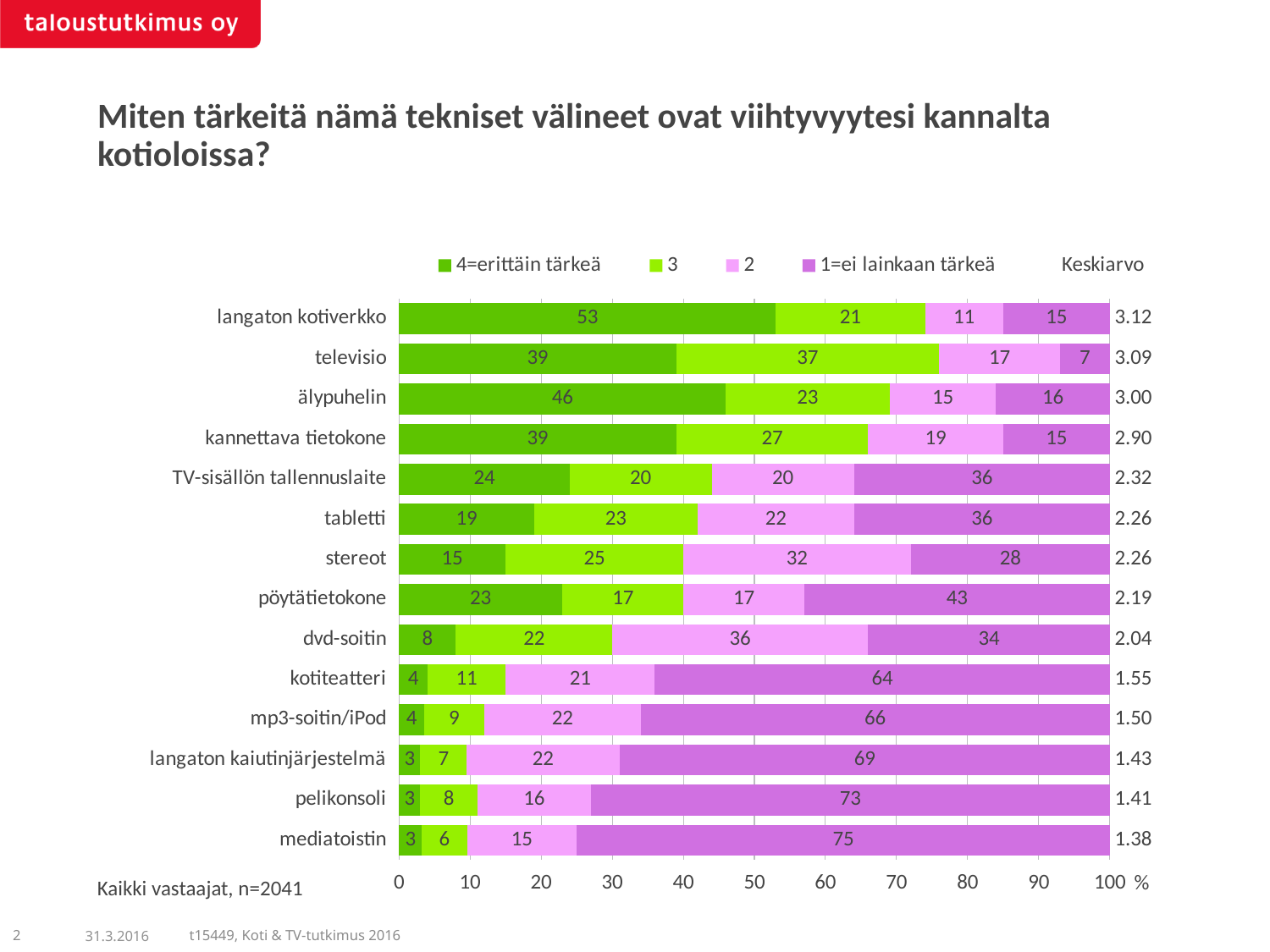
What kind of chart is shown on the slide? stacked bar chart How many series does the legend list? 5 Which has a larger share of 3 ratings, 'televisio' or 'kannettava tietokone'? televisio What percentage of respondents rated 'mediatoistin' as 1=ei lainkaan tärkeä? 75 What percentage of respondents rated 'langaton kotiverkko' as 4=erittäin tärkeä? 53 Which category has the lowest Keskiarvo value? mediatoistin What is the Keskiarvo (mean) value shown for 'televisio'? 3.09 How many categories (technical devices) are shown in the chart? 14 What is the sample size stated on the slide? n=2041 What is the difference between the 1=ei lainkaan tärkeä percentages for 'pelikonsoli' and 'kotiteatteri'? 9 What is the combined percentage of 4=erittäin tärkeä and 3 ratings for 'älypuhelin'? 69 Which category has the highest share of 4=erittäin tärkeä ratings? langaton kotiverkko